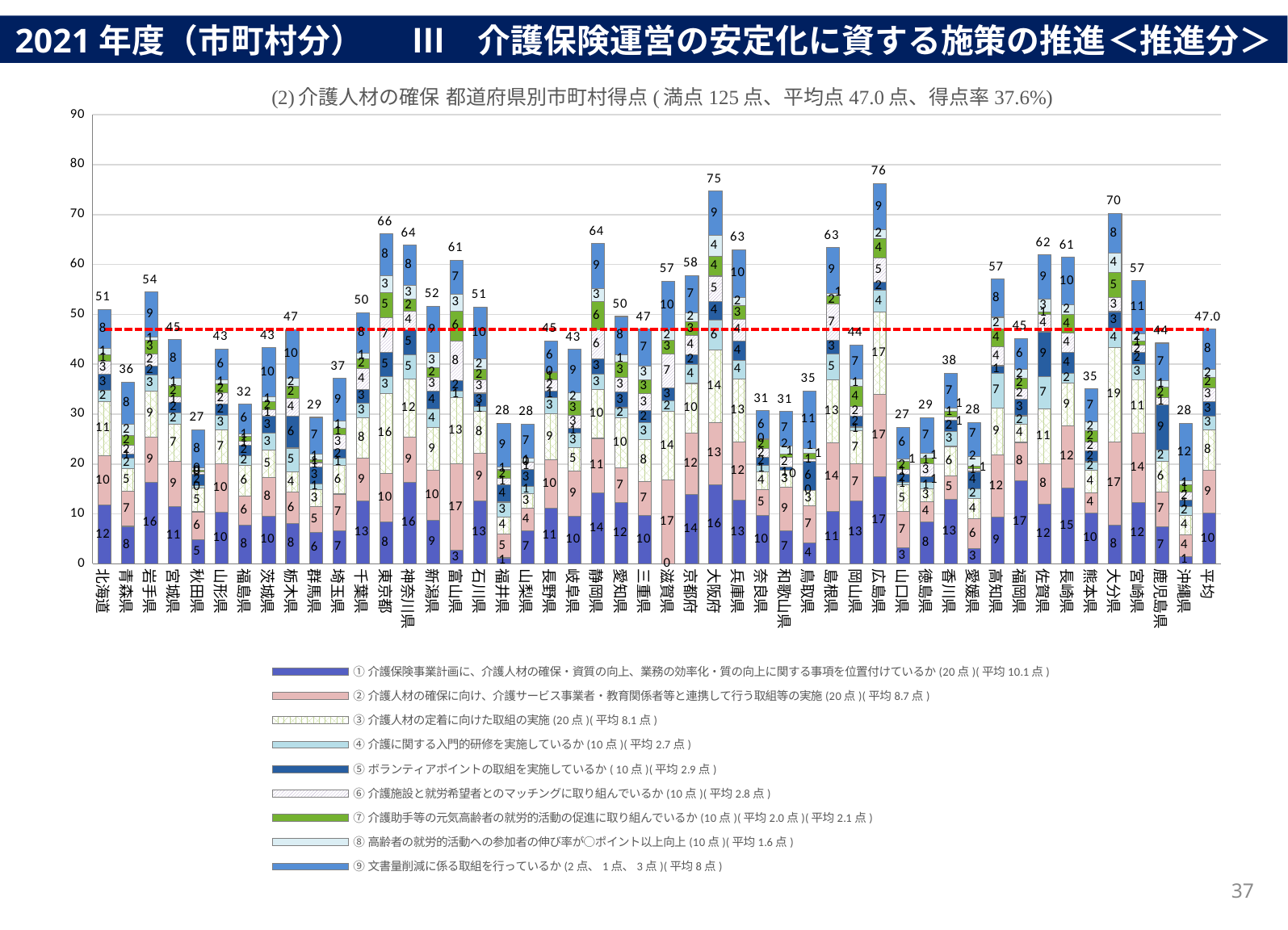
What is the value of the bottom (series ①) segment for 岩手県? 16 Which prefecture has the highest total score? 広島県 What value does the red dashed horizontal line represent? 47.0 Which has a higher total score, 大分県 or 宮崎県? 大分県 Is the total score for 秋田県 greater or less than 30? less What is the total score shown for 平均 (the average bar)? 47.0 How many series does the legend list? 9 What is the total score shown for 大阪府? 75 What is the total score shown for 広島県? 76 What is the difference between the total scores of 東京都 and 青森県? 30 What kind of chart is shown on the slide? stacked bar chart What is the total score shown for 北海道? 51